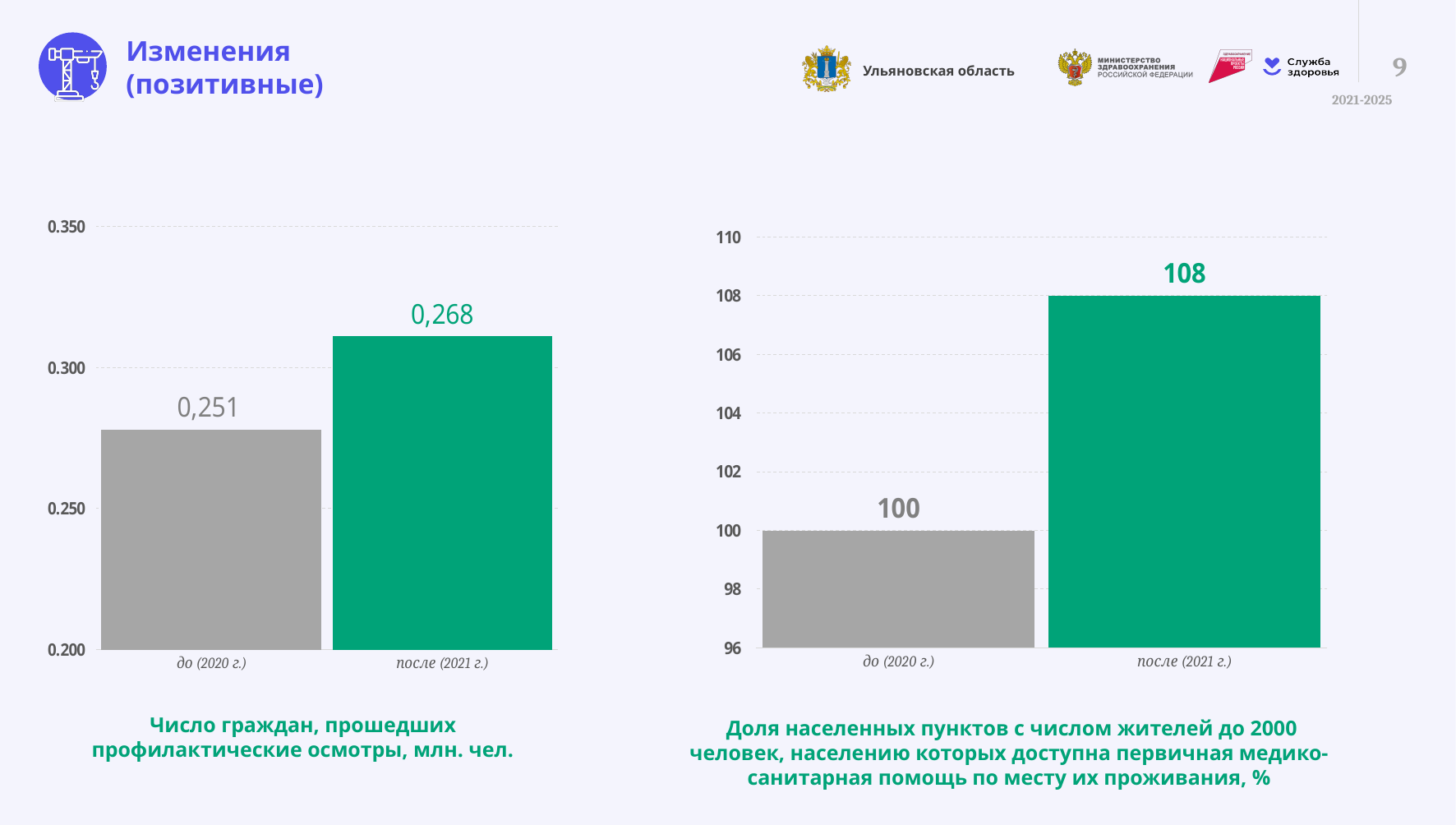
In the left chart, what is the difference between the value for после (2021 г.) and the value for до (2020 г.)? 0,017 In the left chart, which category has the higher value? после (2021 г.) In the right chart (Доля населенных пунктов...), what is the value for до (2020 г.)? 100 In the right chart, do the values rise or fall from до (2020 г.) to после (2021 г.)? rise In the right chart, what is the difference between the value for после (2021 г.) and the value for до (2020 г.)? 8 What type of chart is the right chart? bar chart In the right chart, which category has the lower value? до (2020 г.) In the right chart (Доля населенных пунктов...), what is the value for после (2021 г.)? 108 How many categories does the left chart show? 2 In the left chart (Число граждан, прошедших профилактические осмотры), what is the value for после (2021 г.)? 0,268 In the left chart (Число граждан, прошедших профилактические осмотры), what is the value for до (2020 г.)? 0,251 In the right chart, is the value for после (2021 г.) greater or less than 106? greater